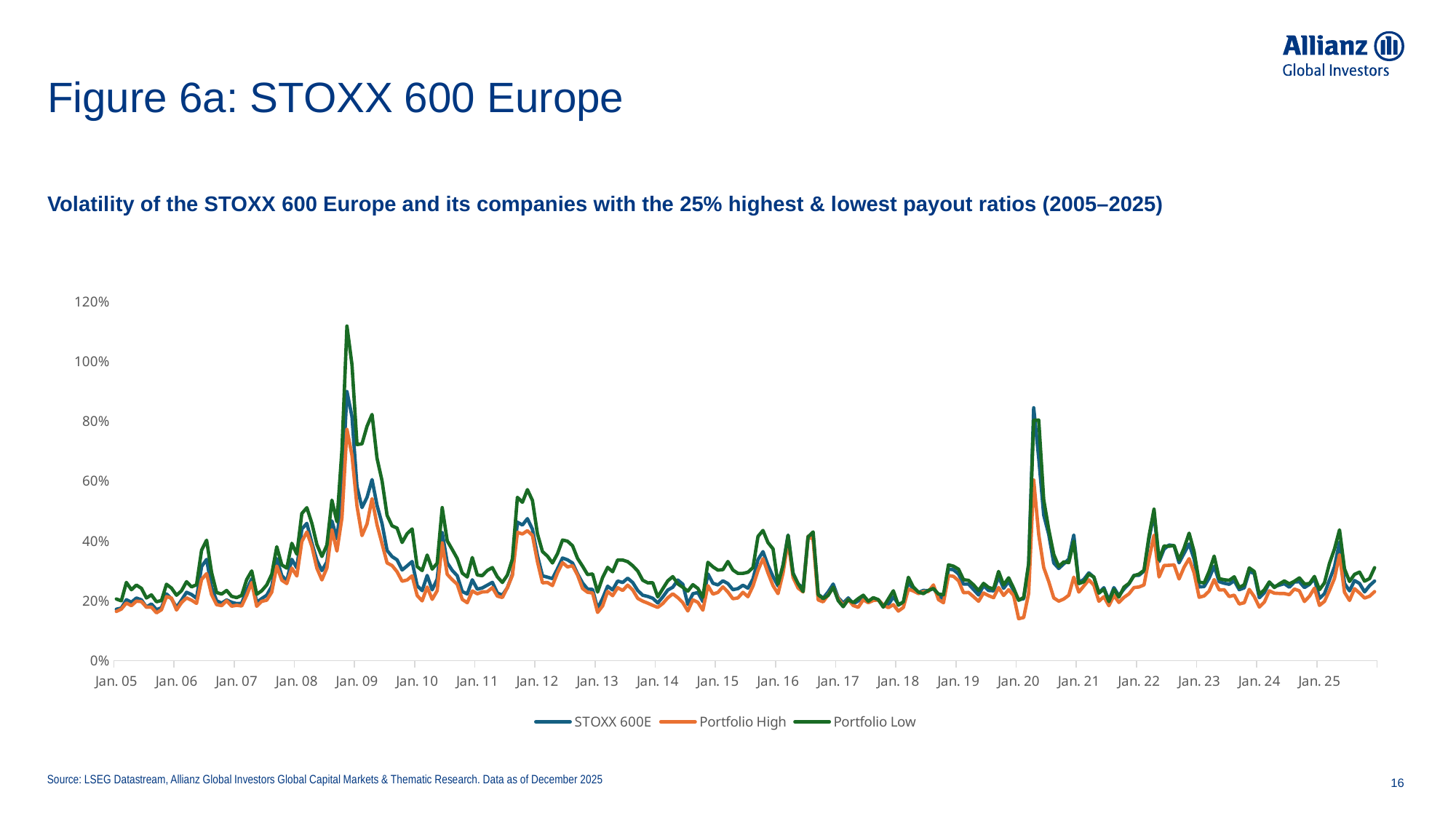
Which series reaches the highest peak around Jan. 09? Portfolio Low Is the peak value of Portfolio High around Jan. 09 greater or less than 100%? less Around Jan. 09, which is larger: the peak of Portfolio Low or the peak of Portfolio High? Portfolio Low How many year labels are shown on the horizontal axis? 21 What kind of chart is shown on the slide? Line chart Is the peak value of STOXX 600E around Jan. 20 greater or less than 60%? greater Which series are listed in the legend? STOXX 600E, Portfolio High, Portfolio Low What colour is the Portfolio High line? Orange Which series has the lowest peak during the spike around Jan. 20? Portfolio High Is the peak value of Portfolio Low around Jan. 09 greater or less than 100%? greater How many series does the legend list? 3 What is the highest value shown on the vertical axis? 120%